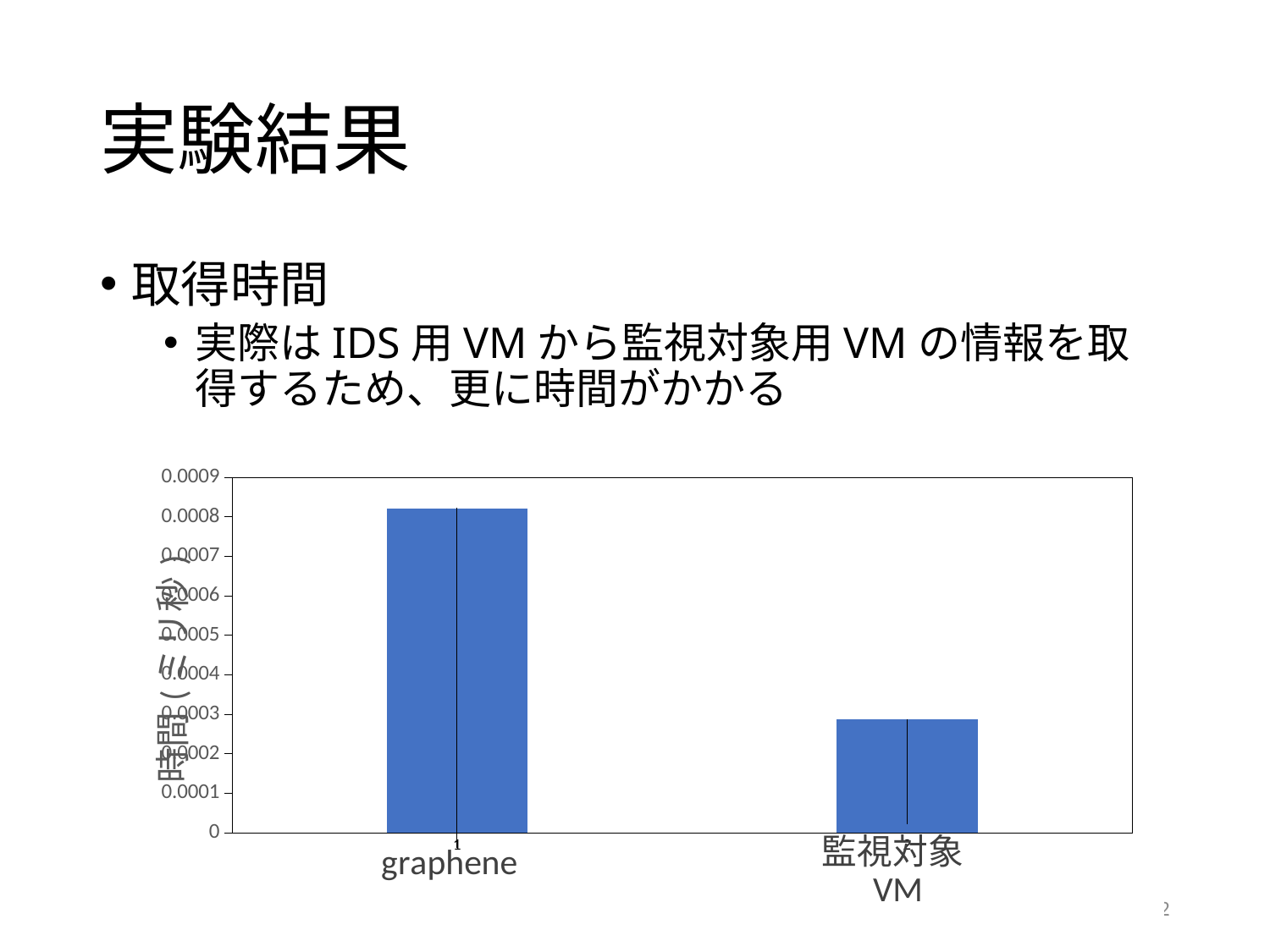
What kind of chart is shown on the slide? bar chart Is the value for 監視対象VM greater or less than 0.0002? greater Is the value for graphene greater or less than 0.0007? greater What is the highest tick value shown on the vertical axis of the chart? 0.0009 Which category has the highest value in the chart? graphene What is the label of the category on the left side of the chart? graphene Is the value for 監視対象VM greater or less than 0.0004? less Which is larger, the value for graphene or the value for 監視対象VM? graphene How many bars (categories) are plotted in the chart? 2 Which category has the lowest value in the chart? 監視対象VM